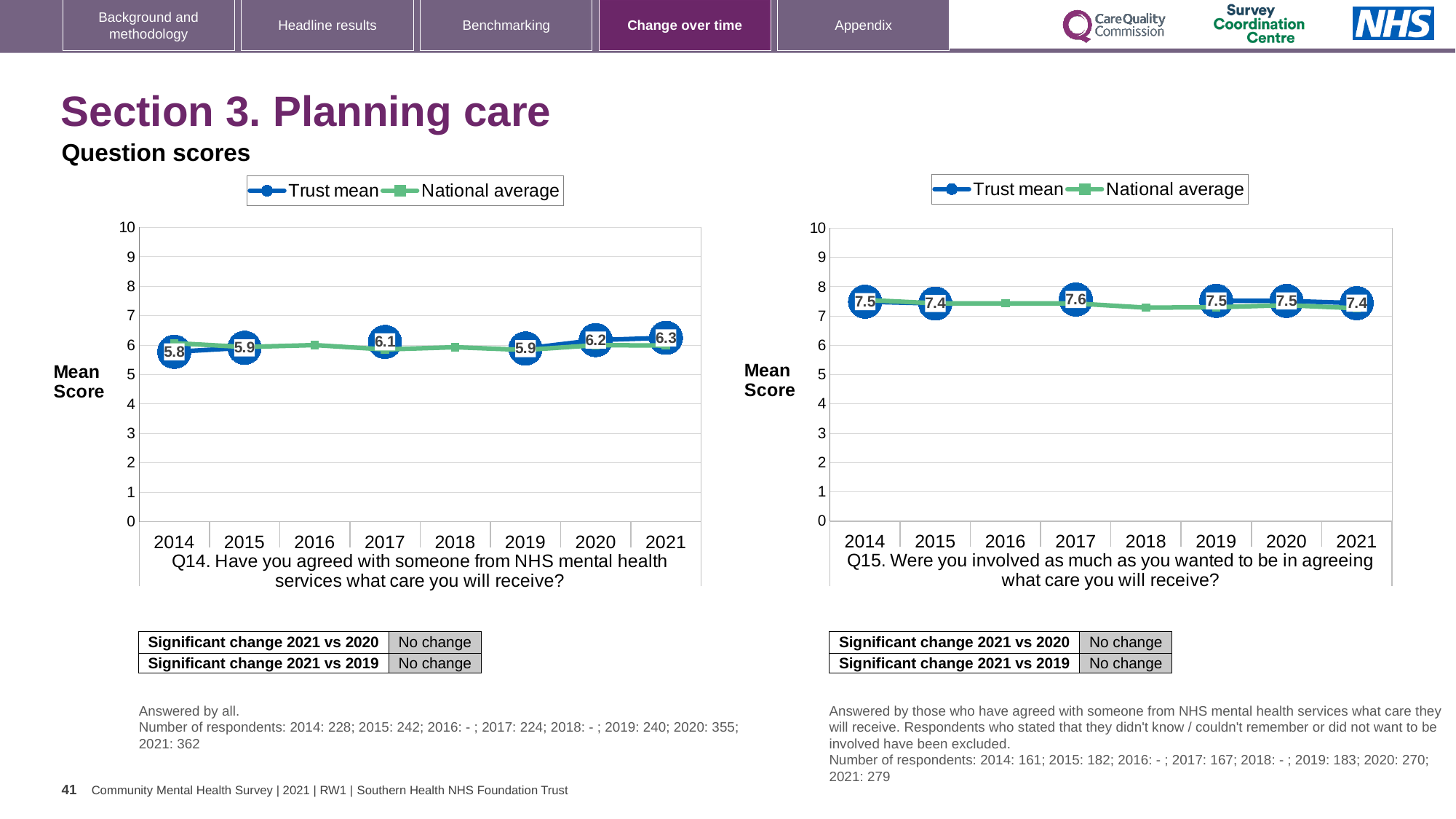
On the Q14 chart (left), in which year is the Trust mean lowest? 2014 On the Q14 chart (left), what is the difference between the Trust mean in 2021 and in 2014? 0.5 On the Q15 chart (right), is the National average for 2018 greater or less than 8? less On the Q14 chart (left), what is the Trust mean for 2021? 6.3 How many years are shown on the x axis of the Q14 chart (left)? 8 What kind of chart is the Q14 chart (left)? Line chart On the Q15 chart (right), what is the Trust mean for 2021? 7.4 How many series does the legend of the Q15 chart (right) list? 2 On the Q14 chart (left), in which year is the Trust mean highest? 2021 On the Q15 chart (right), what is the Trust mean for 2017? 7.6 On the Q15 chart (right), which is larger, the Trust mean for 2017 or for 2015? 2017 On the Q14 chart (left), what is the Trust mean for 2014? 5.8